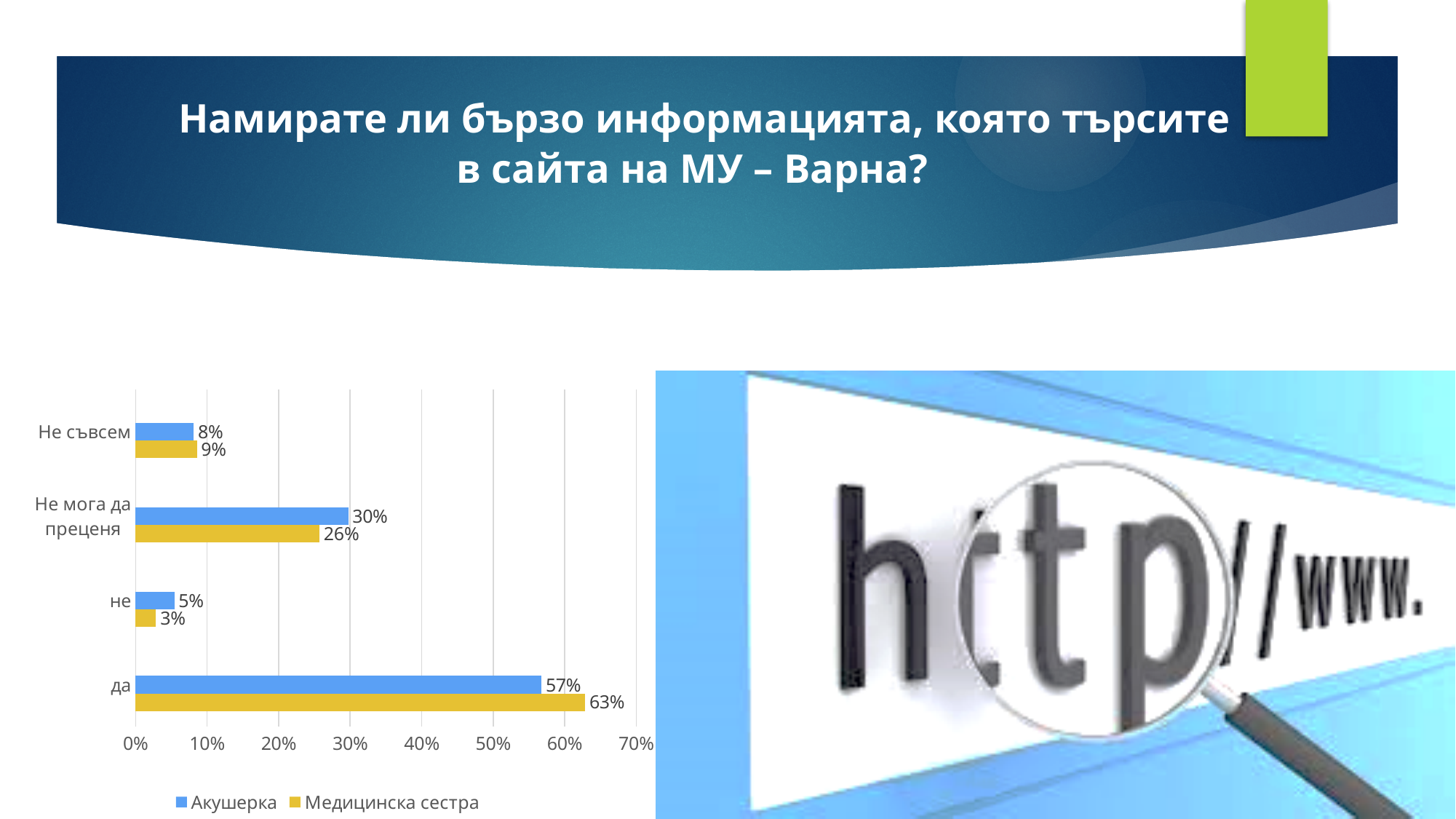
Which series has the larger value in the category 'Не мога да преценя'? Акушерка Is the value for Акушерка in 'да' greater or less than 50%? greater What is the value for Медицинска сестра in the category 'не'? 3% What is the value for Акушерка in the category 'да'? 57% What is the value for Медицинска сестра in the category 'Не мога да преценя'? 26% How many categories are shown on the chart? 4 Which category has the highest value for Медицинска сестра? да Which category has the lowest value for Акушерка? не What colour represents the series Медицинска сестра? yellow How many series does the legend list? 2 What kind of chart is shown on the slide? bar chart What is the difference between the Медицинска сестра and Акушерка values for 'да'? 6%